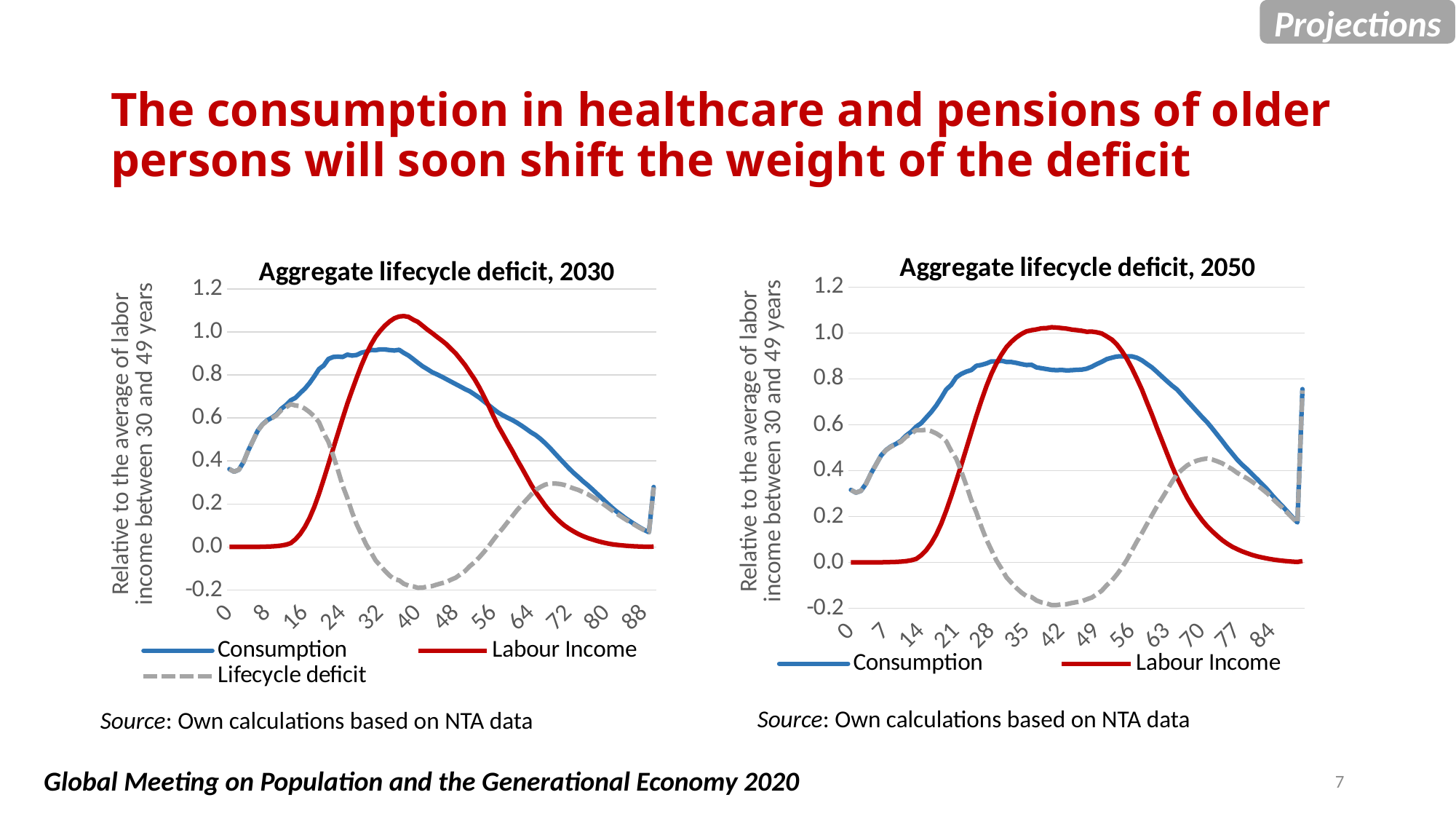
How many series does the legend of the 'Aggregate lifecycle deficit, 2030' chart list? 3 In the 'Aggregate lifecycle deficit, 2050' chart, which series reaches the highest value? Labour Income In the 'Aggregate lifecycle deficit, 2030' chart, does the Labour Income line rise or fall between ages 40 and 88? Fall What kind of chart is the 'Aggregate lifecycle deficit, 2030' chart? Line chart In the 'Aggregate lifecycle deficit, 2030' chart, is the Lifecycle deficit value at age 40 greater or less than 0.0? less In the 'Aggregate lifecycle deficit, 2030' chart, is the Labour Income value at age 40 greater or less than 1.0? greater What is the y-axis label of the 'Aggregate lifecycle deficit, 2030' chart? Relative to the average of labor income between 30 and 49 years In the 'Aggregate lifecycle deficit, 2030' chart, which is larger at age 40: Labour Income or Consumption? Labour Income In the 'Aggregate lifecycle deficit, 2030' chart, which series is drawn as a dashed grey line? Lifecycle deficit How many series does the legend of the 'Aggregate lifecycle deficit, 2050' chart list? 2 In the 'Aggregate lifecycle deficit, 2050' chart, is the Labour Income value at age 0 greater or less than 0.2? less In the 'Aggregate lifecycle deficit, 2050' chart, which is larger at age 70: Consumption or Labour Income? Consumption